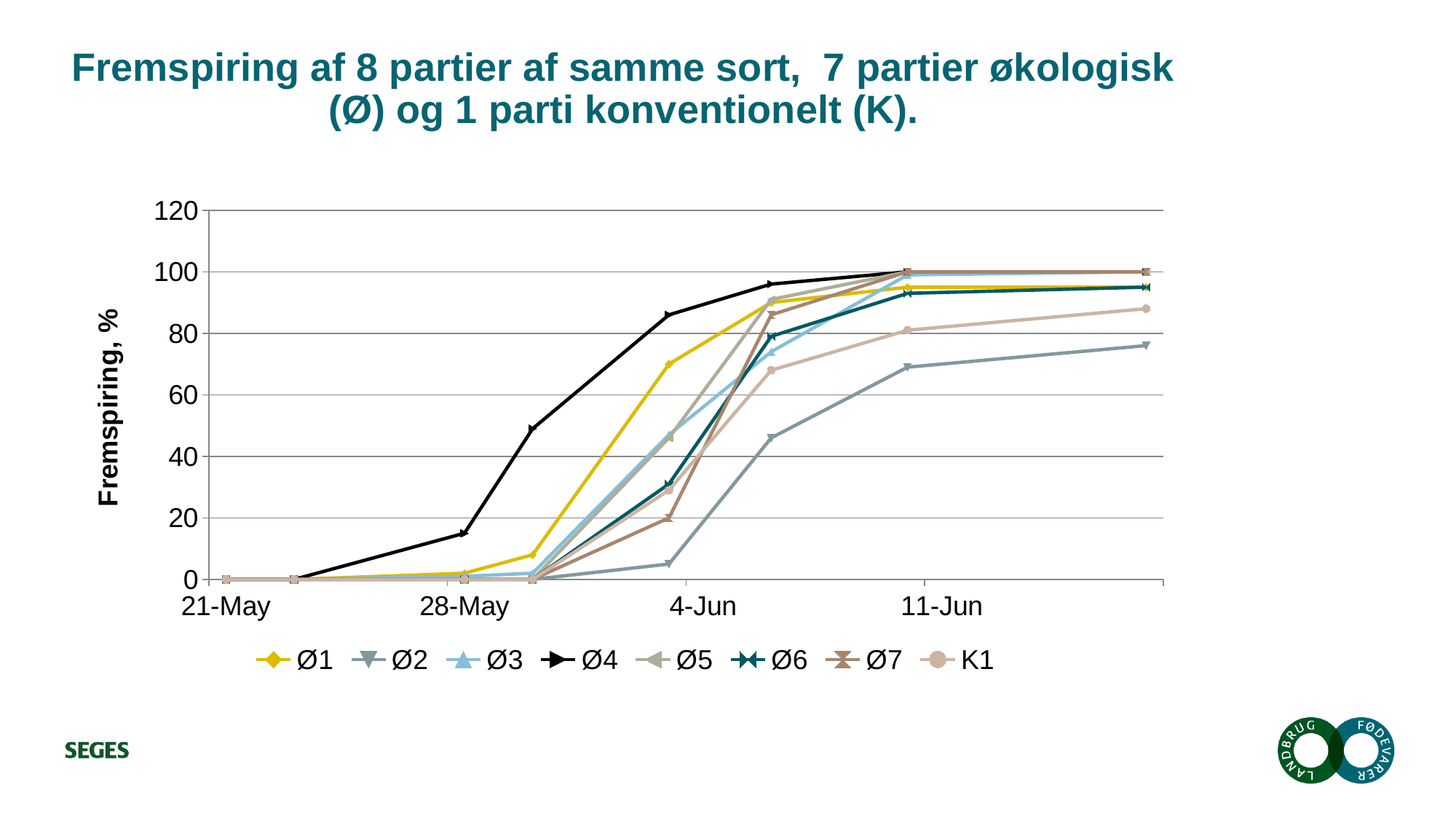
Which series has the lowest value at the last date on the chart? Ø2 Which series is drawn in black? Ø4 Is the value for Ø4 on 28-May greater or less than 20? less Which series has the highest value on 4-Jun? Ø4 Is the value for Ø4 on 4-Jun greater or less than 80? greater Is the value for Ø2 at the last date on the chart greater or less than 80? less Which is larger on 4-Jun, the value for Ø4 or the value for Ø1? Ø4 What is the value for Ø4 on 21-May? 0 How many series does the legend list? 8 Do the values for Ø4 rise or fall from 21-May to 11-Jun? rise What is the label of the y axis? Fremspiring, % What kind of chart is shown on the slide? line chart